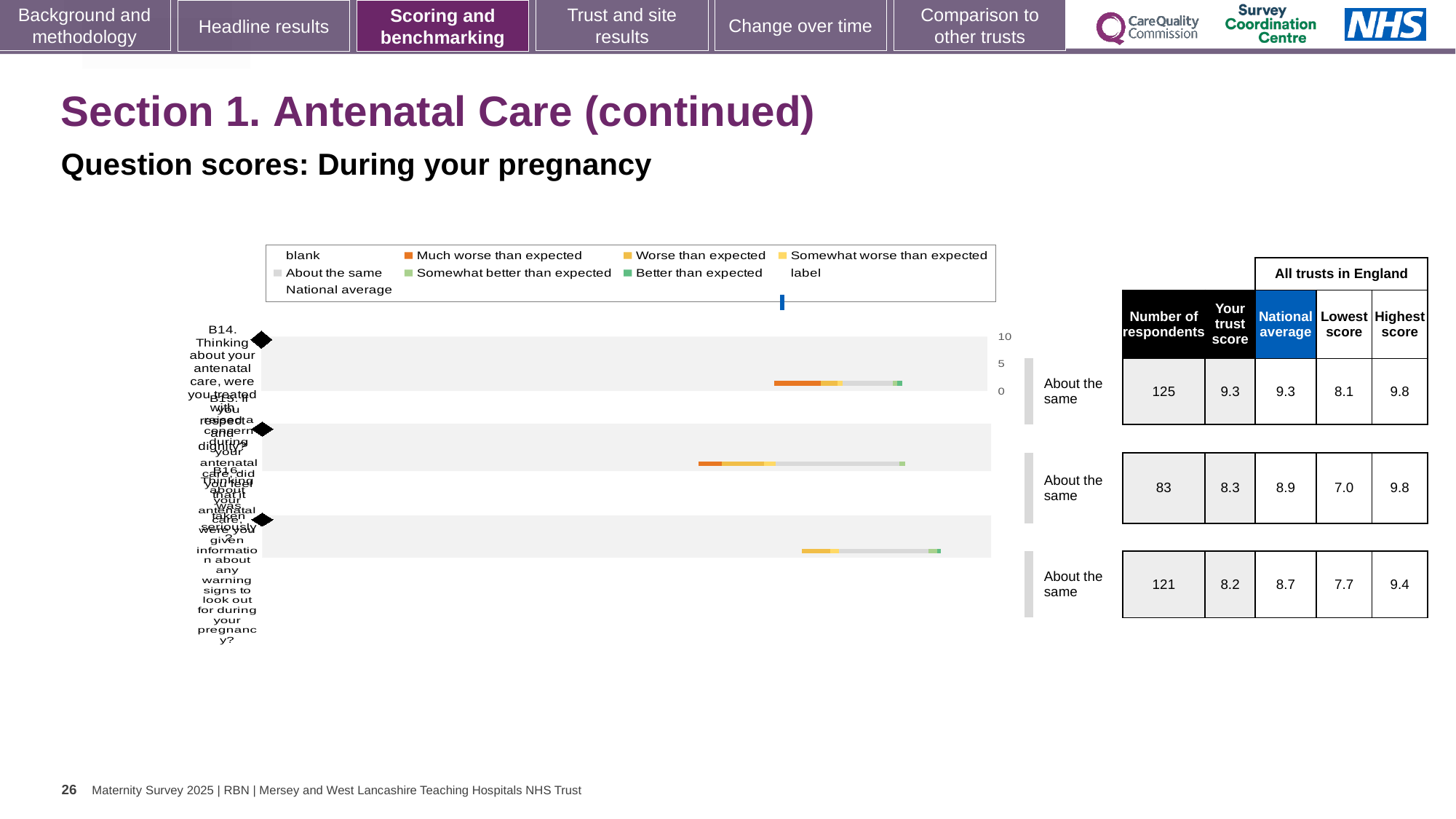
In the table beside the chart, what is the number of respondents for the first row (B14, treated with respect and dignity)? 125 How many survey questions are plotted as rows in the chart? 3 Which row has the highest number of respondents? The first row (B14), 125 What is the trust score for the first row (B14) in the table? 9.3 For the second row, what is the difference between the national average and the trust score? 0.6 For the third row, which is larger: the trust score or the national average? National average Which row has the lowest 'Lowest score' value? The second row, 7.0 What is the national average for the second row in the table? 8.9 What kind of chart is shown on the slide? Bar chart What benchmark rating is shown next to each of the three rows? About the same What is the highest score for the third row in the table? 9.4 What is the lowest score for the second row in the table? 7.0